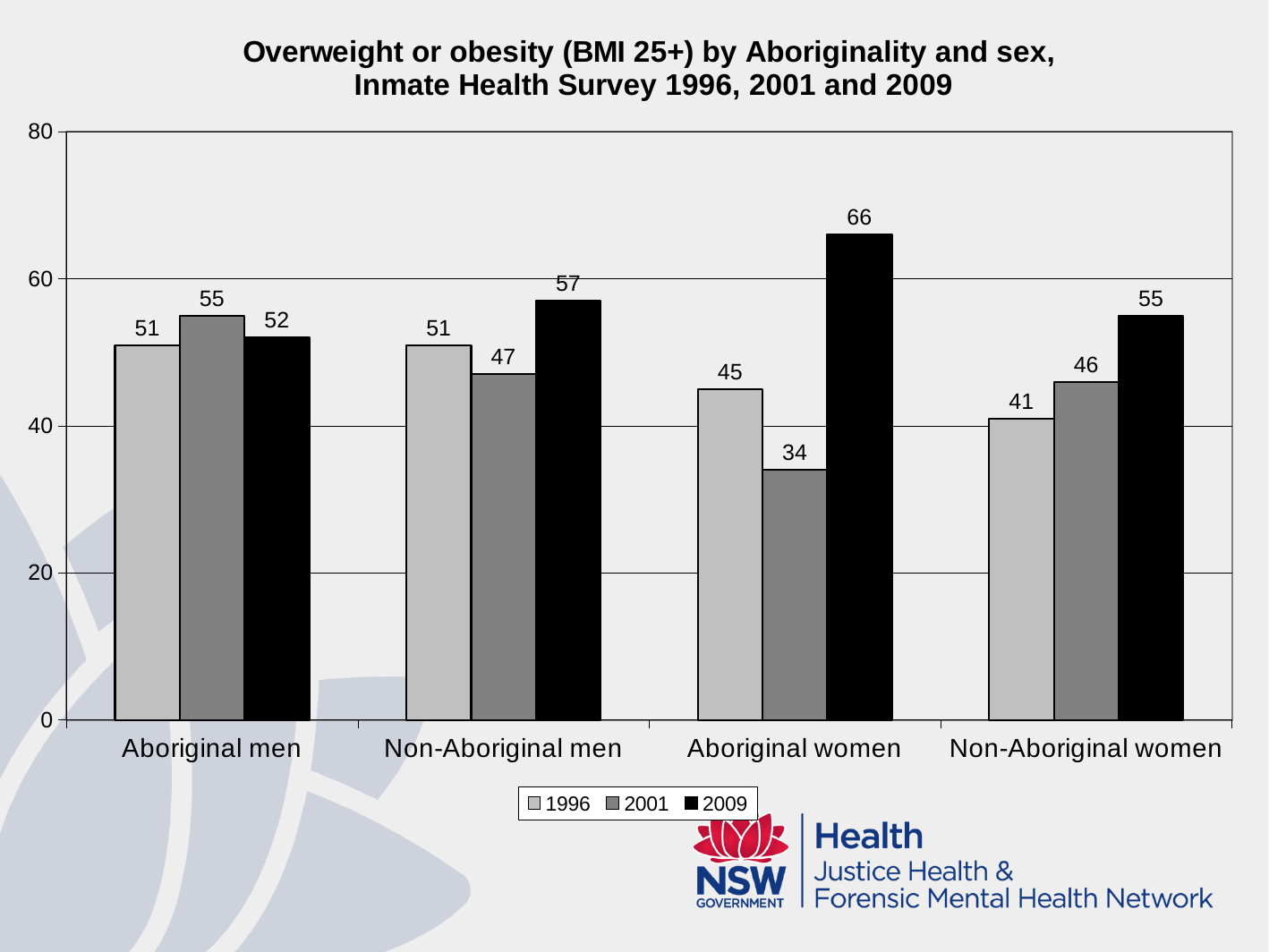
Which category has the lowest value in 2001? Aboriginal women How many categories are shown on the x axis? 4 Which is larger: the 2001 value for Aboriginal men or the 2001 value for Non-Aboriginal men? Aboriginal men What is the difference between the 2009 and 2001 values for Aboriginal women? 32 What is the value for Non-Aboriginal women in 1996? 41 Which series is shown in black in the legend? 2009 Which category has the highest value in 2009? Aboriginal women What is the value for Aboriginal women in 2009? 66 What is the value for Non-Aboriginal men in 2001? 47 What kind of chart is shown on the slide? Bar chart Do the values for Non-Aboriginal women rise or fall from 1996 to 2009? Rise How many series does the legend list? 3